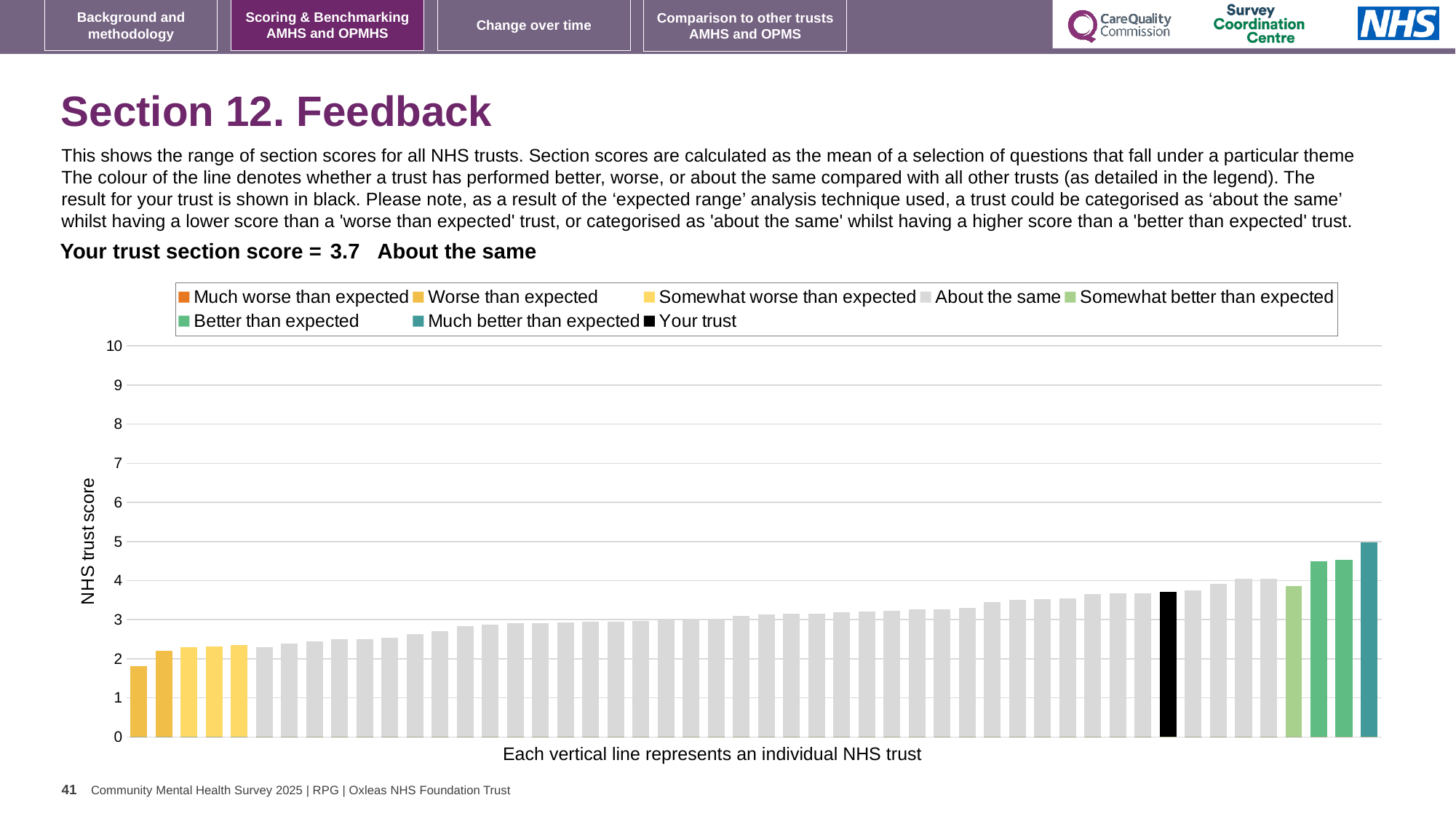
Is the value of the shortest bar in the chart greater or less than 2? less Which legend category does the shortest bar in the chart belong to? Worse than expected What is the label on the vertical axis of the chart? NHS trust score Which legend category does the tallest bar in the chart belong to? Much better than expected How many entries does the chart legend list? 8 What kind of chart is shown on the slide? bar chart Do the bar values rise or fall from left to right along the x axis? rise Which is larger: the value of the 'Your trust' bar or the value of the leftmost bar? Your trust Which benchmark category is your trust's section score placed in? About the same Is the value of the tallest bar in the chart greater or less than 4? greater What is the section score for your trust shown on the slide? 3.7 Is the value of the black 'Your trust' bar greater or less than 3? greater